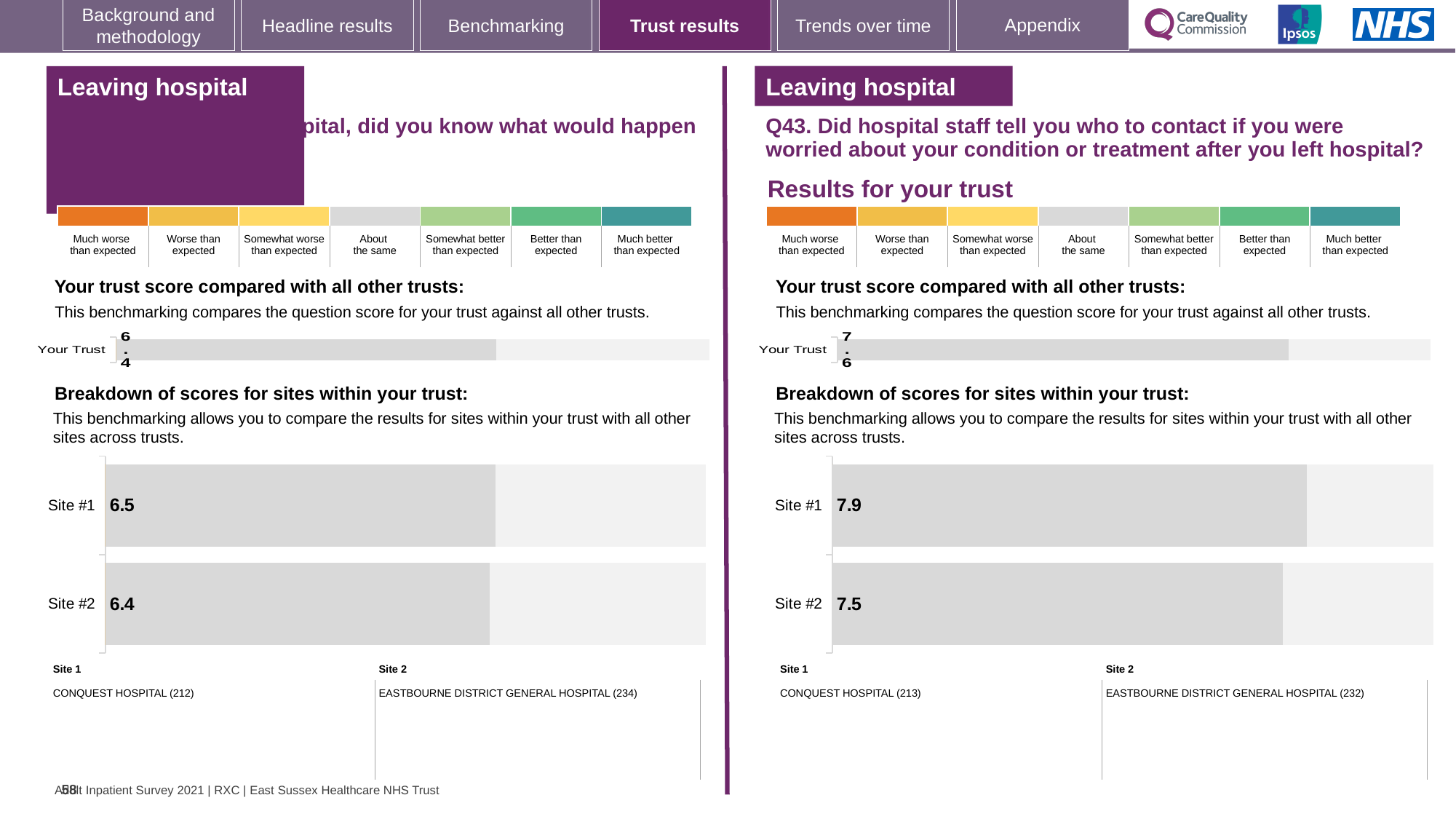
On the left-hand site breakdown chart, what is the score for Site #2? 6.4 On the left-hand site breakdown chart, what is the difference between the Site #1 and Site #2 scores? 0.1 On the right-hand (Q43) site breakdown chart, which site has the higher score? Site #1 On the right-hand (Q43) site breakdown chart, what is the score for Site #1? 7.9 What type of chart is the right-hand (Q43) site breakdown chart? Bar chart On the right-hand (Q43) site breakdown chart, what is the score for Site #2? 7.5 On the right-hand (Q43) 'Your trust score compared with all other trusts' chart, what is the score for Your Trust? 7.6 How many sites are shown on the right-hand (Q43) site breakdown chart? 2 On the right-hand (Q43) site breakdown chart, what is the difference between the Site #1 and Site #2 scores? 0.4 On the right-hand (Q43) site breakdown chart, which hospital is listed as Site 2? EASTBOURNE DISTRICT GENERAL HOSPITAL (232) On the left-hand site breakdown chart, what is the score for Site #1? 6.5 On the left-hand 'Your trust score compared with all other trusts' chart, what is the score for Your Trust? 6.4